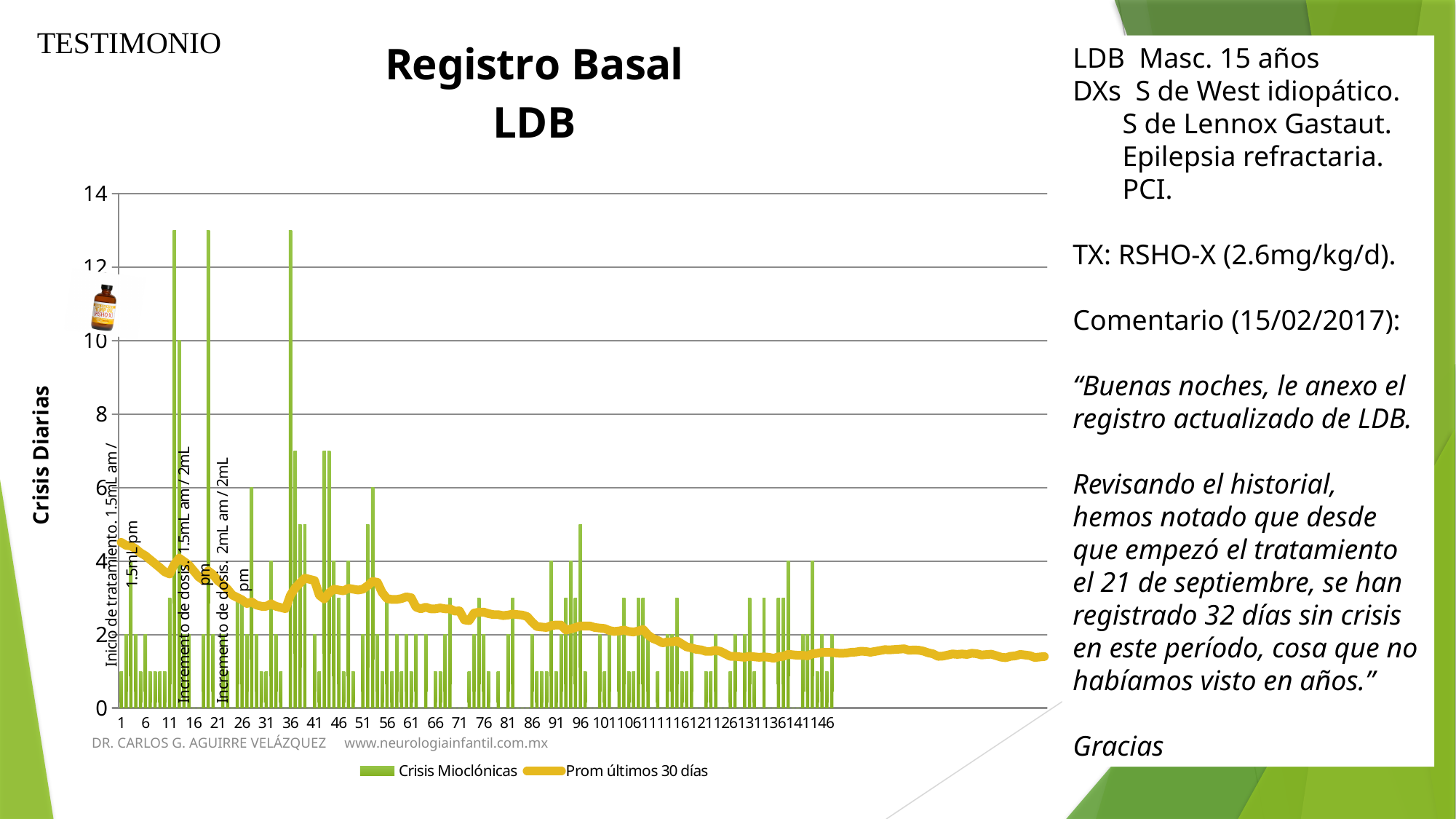
Does the Prom últimos 30 días line generally rise or fall from left to right along the x axis? fall Is the value of the Prom últimos 30 días line at the right end of the chart greater or less than 2? less What is the title of the chart? Registro Basal LDB What is the highest value shown on the y axis? 14 What kind of chart is used to plot the Crisis Mioclónicas series? bar chart Is the tallest Crisis Mioclónicas bar greater or less than 12? greater How many series does the chart legend list? 2 Which series is drawn as a line rather than bars? Prom últimos 30 días